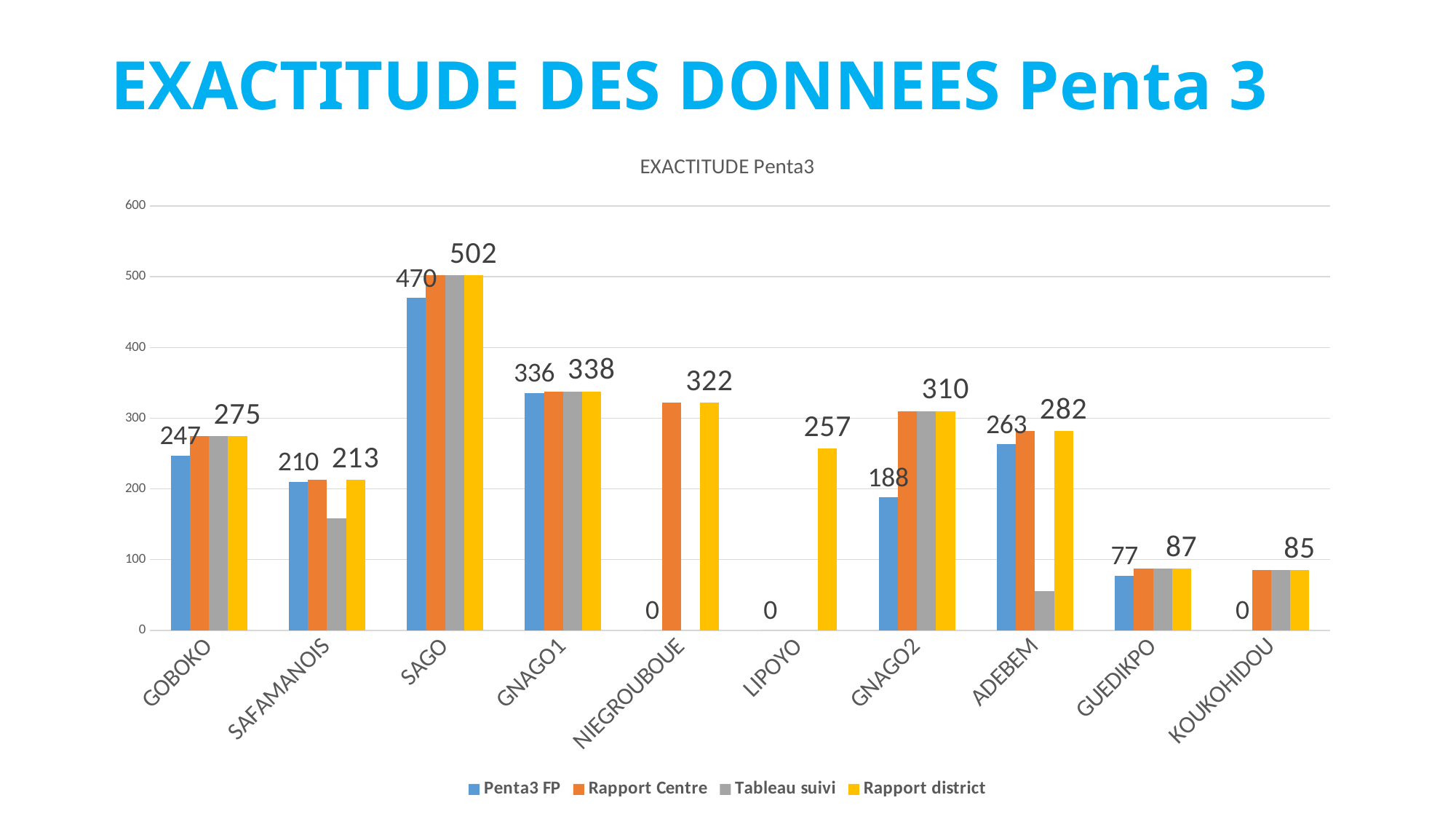
What is the Penta3 FP value for SAGO? 470 Which category has the highest Rapport district value? SAGO What is the difference between the Rapport district value and the Penta3 FP value for GNAGO2? 122 Which category has the lowest Rapport district value? KOUKOHIDOU What is the Penta3 FP value for GUEDIKPO? 77 Is the Tableau suivi value for SAFAMANOIS greater or less than 200? less How many series does the legend list? 4 What type of chart is shown on the slide? bar chart What is the Rapport district value for GNAGO2? 310 How many categories are shown on the x axis? 10 Which is larger for ADEBEM: the Penta3 FP value or the Rapport district value? Rapport district What is the title of the chart? EXACTITUDE Penta3